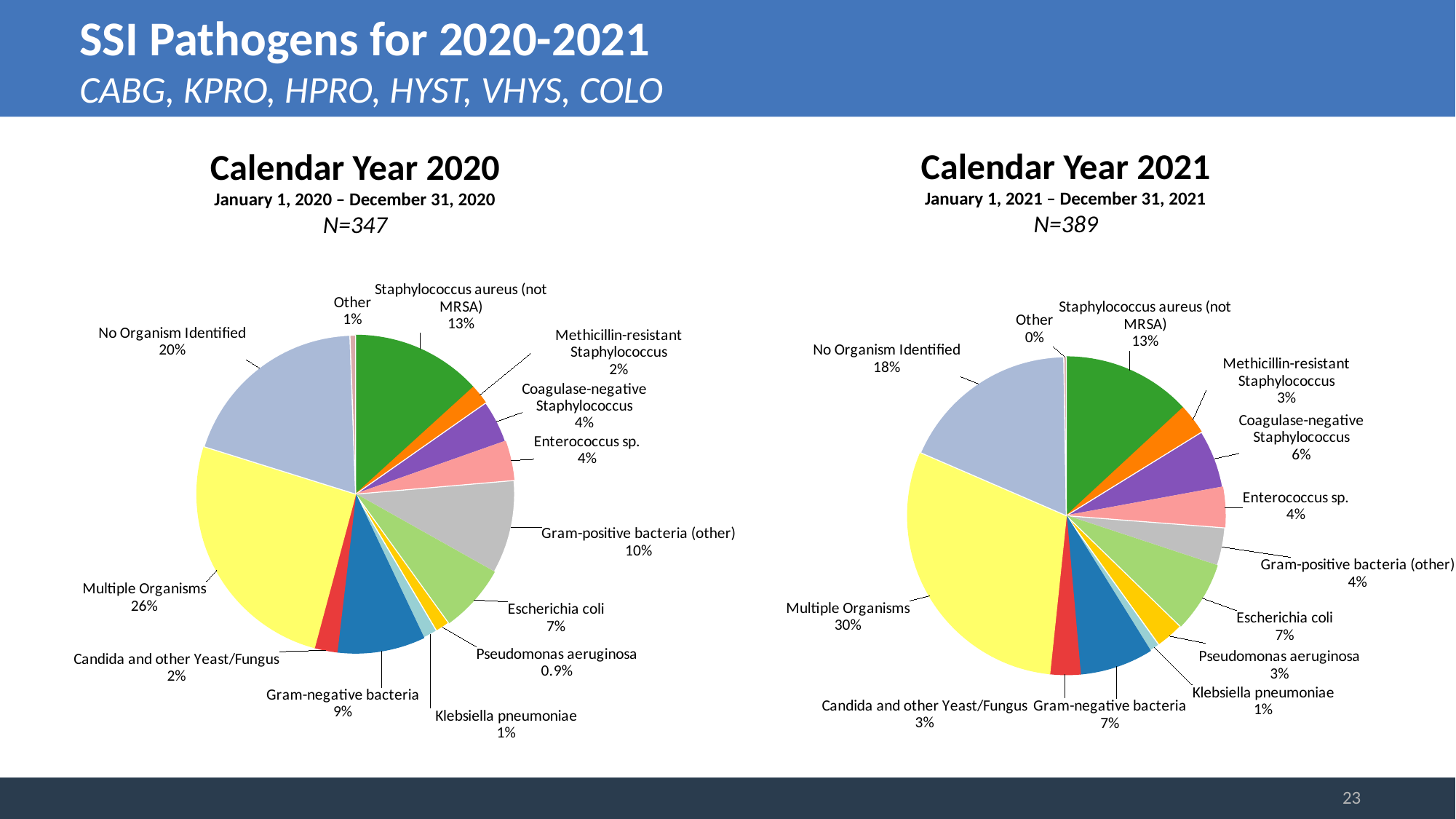
In the Calendar Year 2020 chart, what share is Multiple Organisms? 26% What is the N value shown for the Calendar Year 2021 chart? N=389 In the Calendar Year 2021 chart, which category has the smallest share? Other In the Calendar Year 2021 chart, what share is No Organism Identified? 18% In the Calendar Year 2020 chart, what is the difference in percentage points between Multiple Organisms and No Organism Identified? 6 In the Calendar Year 2021 chart, what share is Gram-positive bacteria (other)? 4% In the Calendar Year 2020 chart, which is larger: Gram-positive bacteria (other) or Gram-negative bacteria? Gram-positive bacteria (other) In the Calendar Year 2020 chart, what share is Pseudomonas aeruginosa? 0.9% In the Calendar Year 2021 chart, what share is Coagulase-negative Staphylococcus? 6% In the Calendar Year 2021 chart, which category has the largest share? Multiple Organisms What type of chart is used for Calendar Year 2020? Pie chart How many categories are shown in the Calendar Year 2021 chart? 13